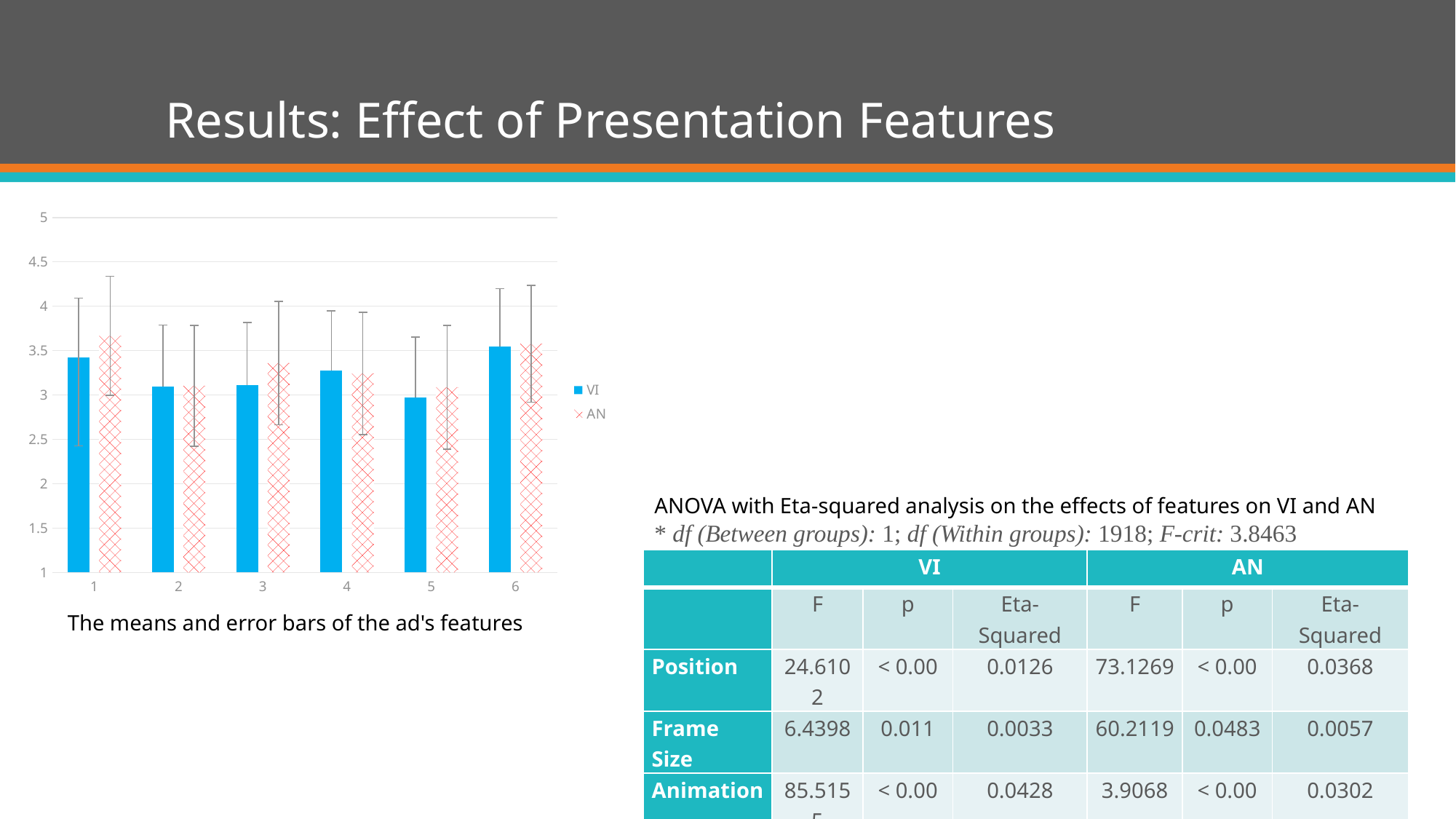
What kind of chart is shown on the left of the slide? bar chart Is the VI value for category 2 greater or less than 3.5? less How many categories are shown on the x axis of the bar chart? 6 What are the two series named in the legend of the bar chart? VI and AN Which category has the lowest VI value in the bar chart? 5 Is the VI value for category 1 greater or less than 3? greater For category 3, which series has the larger value, VI or AN? AN What is the caption printed below the bar chart? The means and error bars of the ad's features For category 1, which series has the larger value, VI or AN? AN How many series does the legend of the bar chart list? 2 Which category has the highest VI value in the bar chart? 6 Is the AN value for category 1 greater or less than 3.5? greater